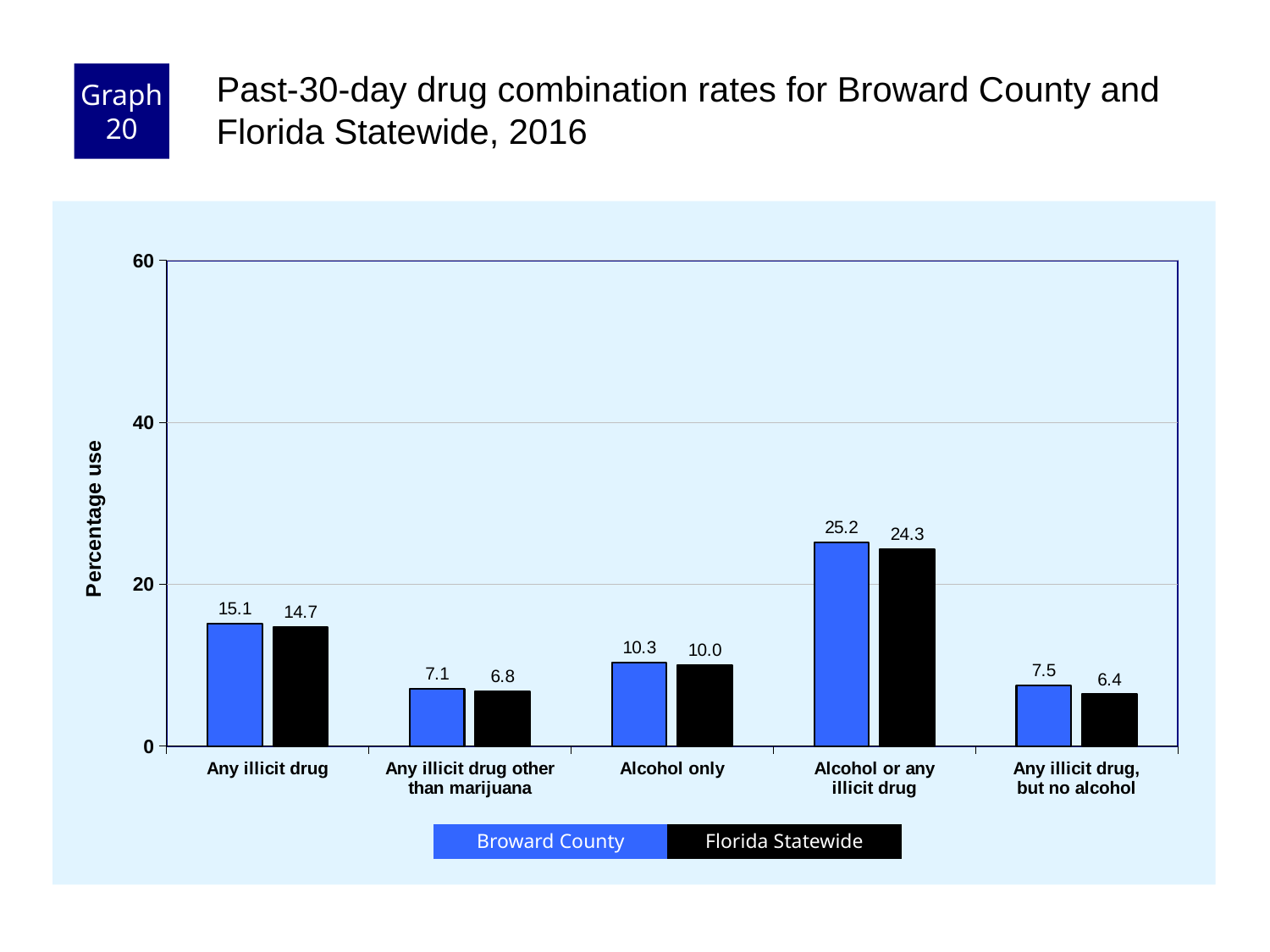
What is the difference between the Broward County and Florida Statewide values for Alcohol or any illicit drug? 0.9 Which is larger for Alcohol only: the Broward County value or the Florida Statewide value? Broward County What is the label of the y axis? Percentage use What kind of chart is shown on the slide? bar chart Is the Broward County value for Alcohol or any illicit drug greater or less than 20? greater What is the Florida Statewide value for Alcohol or any illicit drug? 24.3 What is the Florida Statewide value for Any illicit drug, but no alcohol? 6.4 Which category has the lowest Florida Statewide value? Any illicit drug, but no alcohol What is the Broward County value for Any illicit drug? 15.1 Which category has the highest Broward County value? Alcohol or any illicit drug How many categories are shown on the x axis? 5 How many series does the legend list? 2